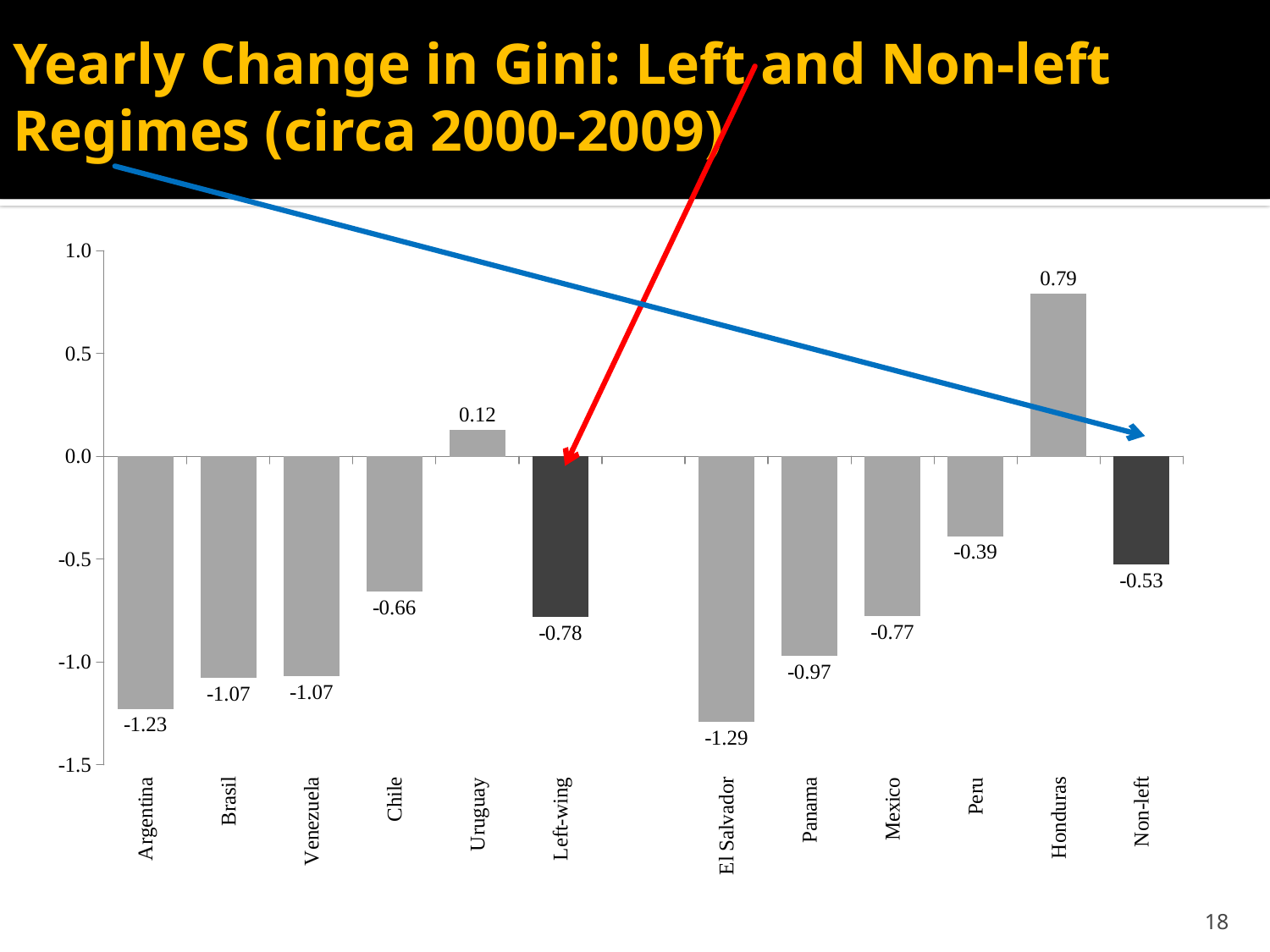
Which has a larger value, Uruguay or Chile? Uruguay What is the value shown for the Non-left bar? -0.53 What is the value shown for Honduras? 0.79 What is the yearly change in Gini for Argentina? -1.23 What is the difference between the Left-wing value and the Non-left value? 0.25 Is the value for Panama greater or less than -0.5? less What is the value shown for Peru? -0.39 Which category has the lowest value? El Salvador How many bars are plotted in the chart? 12 What kind of chart is shown on the slide? bar chart Which category has the highest value? Honduras What is the value shown for the Left-wing bar? -0.78